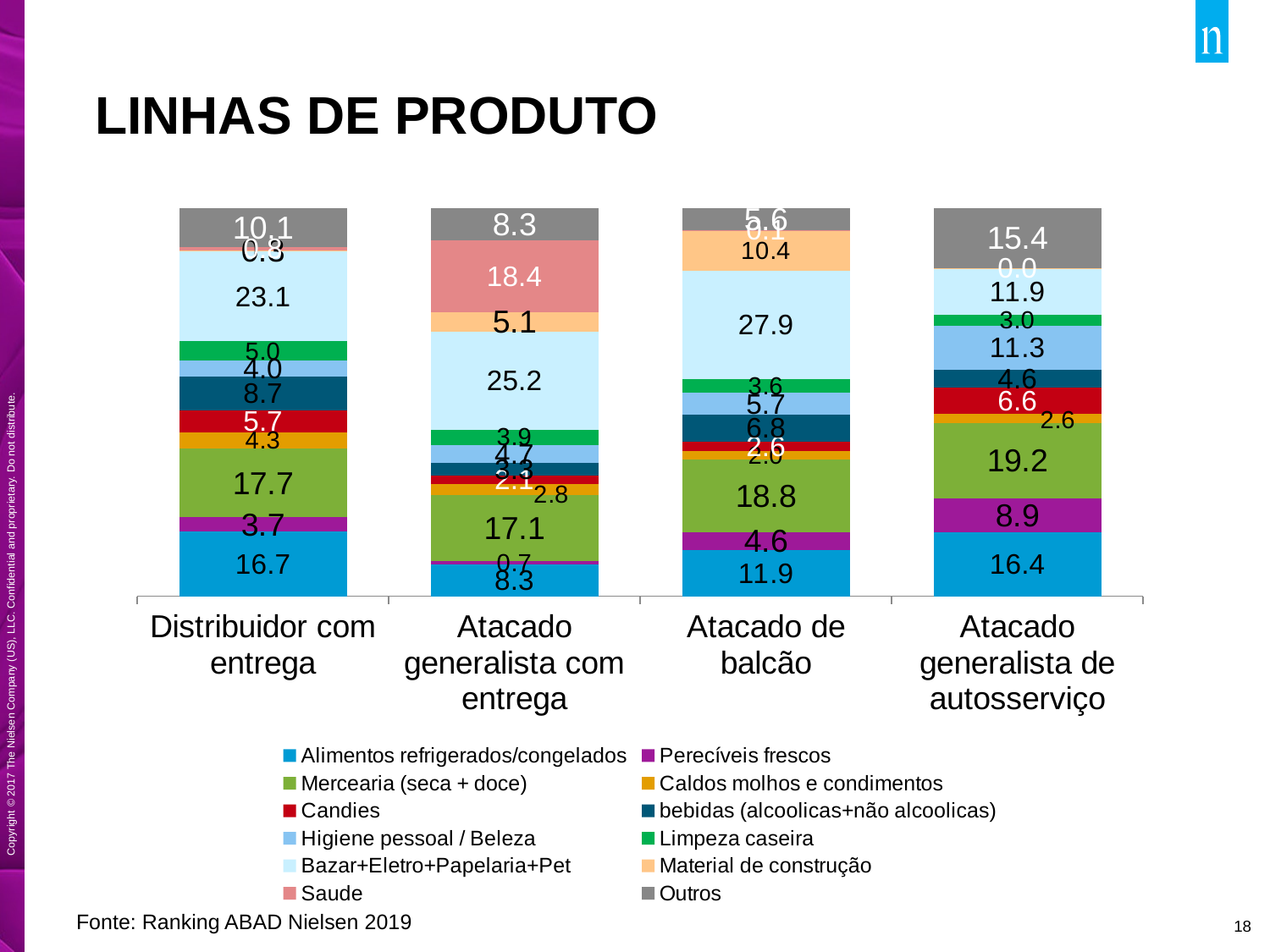
Which is larger: Perecíveis frescos for Atacado generalista de autosserviço or for Atacado de balcão? Atacado generalista de autosserviço What is the value of Alimentos refrigerados/congelados for Distribuidor com entrega? 16.7 How many series does the legend list? 12 How many categories are shown along the x axis? 4 What is the difference between the Mercearia (seca + doce) values for Atacado generalista de autosserviço and Atacado generalista com entrega? 2.1 What is the value of Outros for Atacado generalista de autosserviço? 15.4 What kind of chart is shown on the slide? stacked bar chart Which category has the lowest value for Alimentos refrigerados/congelados? Atacado generalista com entrega What is the value of Mercearia (seca + doce) for Atacado generalista de autosserviço? 19.2 What is the value of Saude for Atacado generalista com entrega? 18.4 Which category has the highest value for Bazar+Eletro+Papelaria+Pet? Atacado de balcão What is the value of Bazar+Eletro+Papelaria+Pet for Atacado de balcão? 27.9